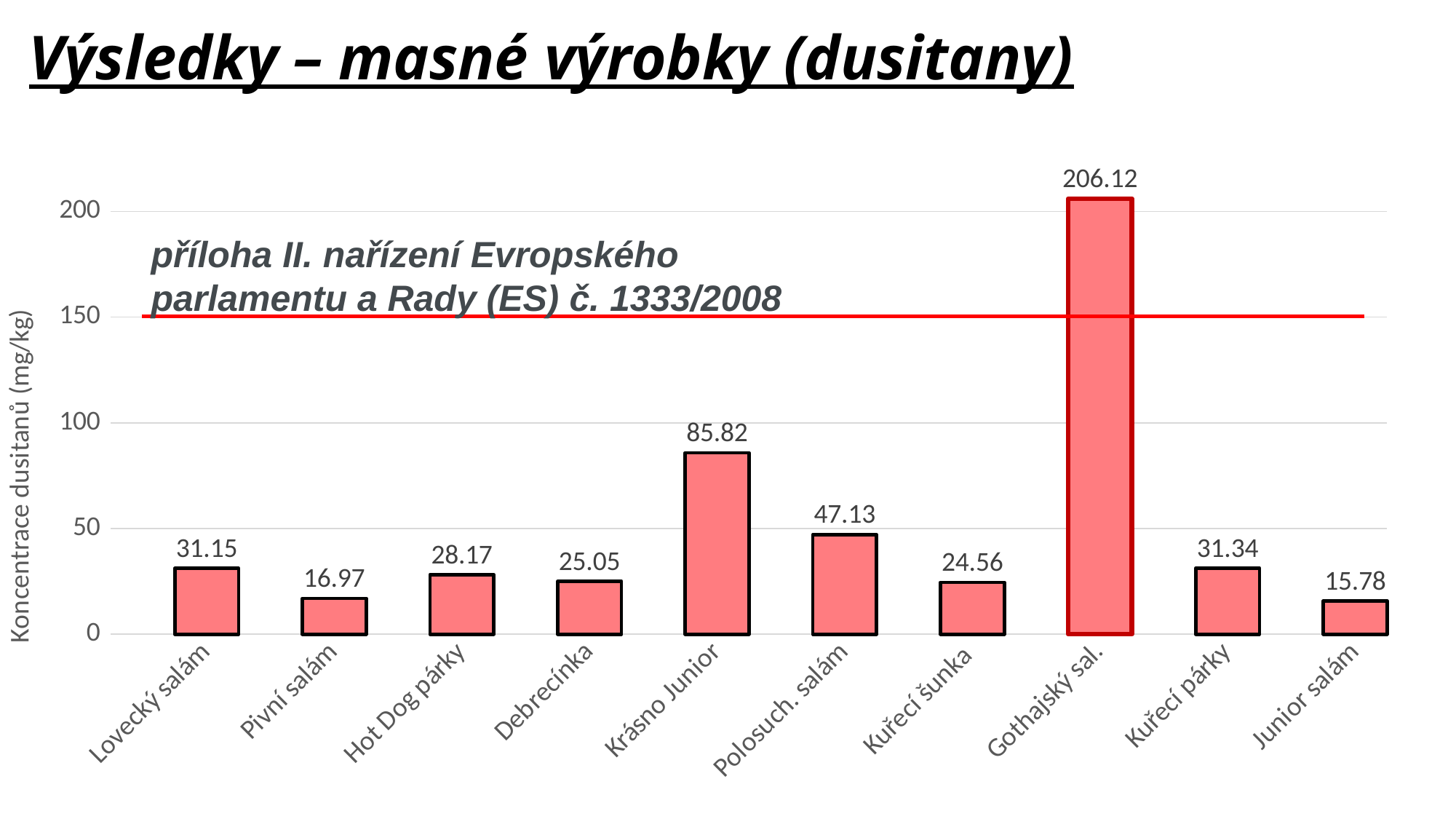
What is the difference between the values for Gothajský sal. and Krásno Junior? 120.30 What is the value shown for Pivní salám? 16.97 How many products are shown on the x axis? 10 Which product has the highest nitrite concentration? Gothajský sal. Is the value for Gothajský sal. greater or less than 150? greater Which has a higher value, Hot Dog párky or Debrecínka? Hot Dog párky What is the difference between the values for Polosuch. salám and Kuřecí šunka? 22.57 Which product has the lowest nitrite concentration? Junior salám What kind of chart is shown on the slide? bar chart What is the label of the y axis? Koncentrace dusitanů (mg/kg) What is the value shown for Krásno Junior? 85.82 What is the nitrite concentration for Gothajský sal.? 206.12